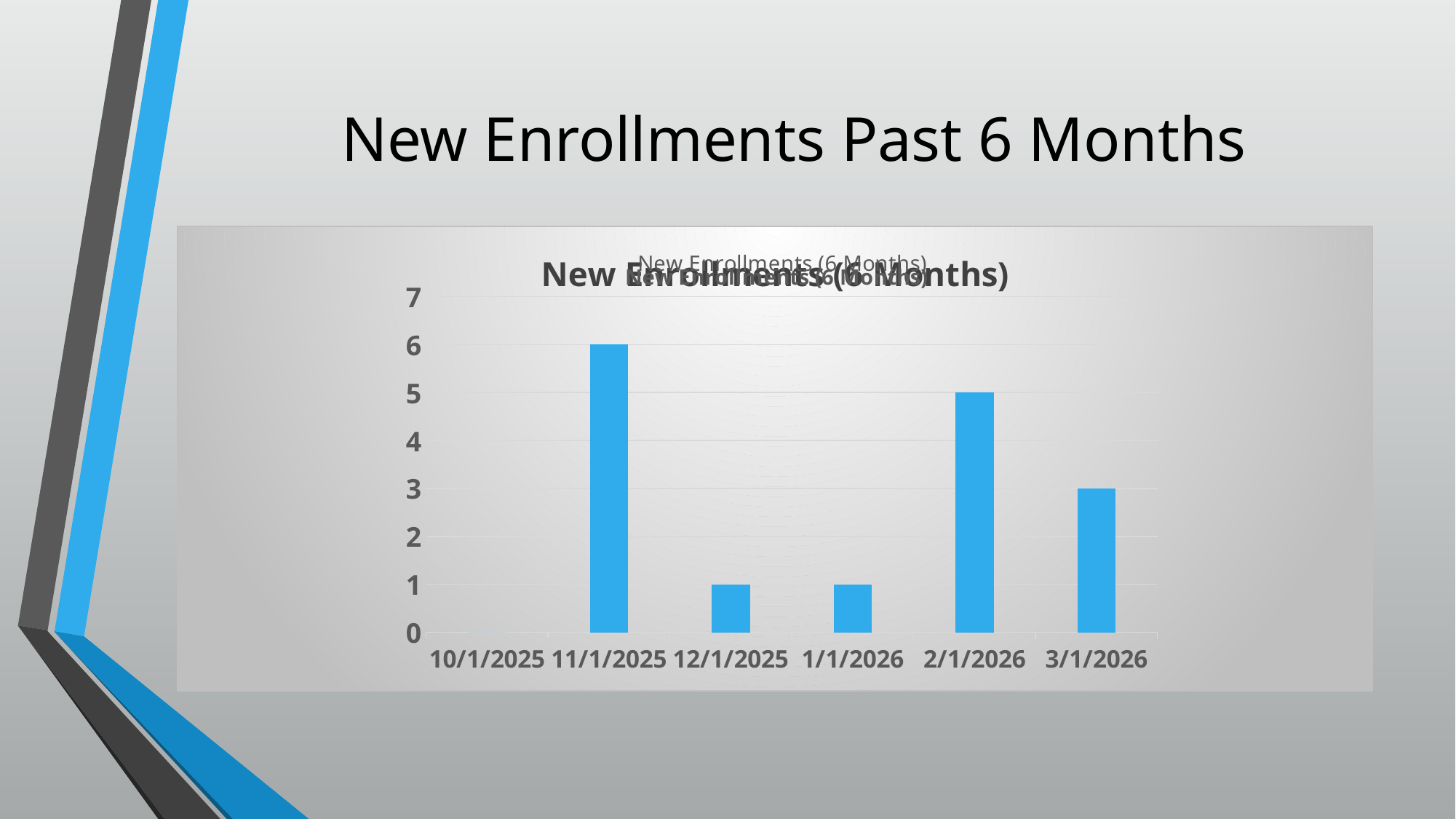
What is the difference between the values for 11/1/2025 and 2/1/2026? 1 Is the value for 11/1/2025 greater or less than 4? greater What is the value for 11/1/2025? 6 What is the value for 12/1/2025? 1 What is the title of the chart? New Enrollments (6 Months) Which month has the lowest number of new enrollments? 10/1/2025 What is the value for 3/1/2026? 3 Which is larger, the value for 2/1/2026 or the value for 3/1/2026? 2/1/2026 What kind of chart is shown on the slide? bar chart How many months (categories) are shown on the x axis of the chart? 6 What is the value for 2/1/2026? 5 Which month has the highest number of new enrollments? 11/1/2025